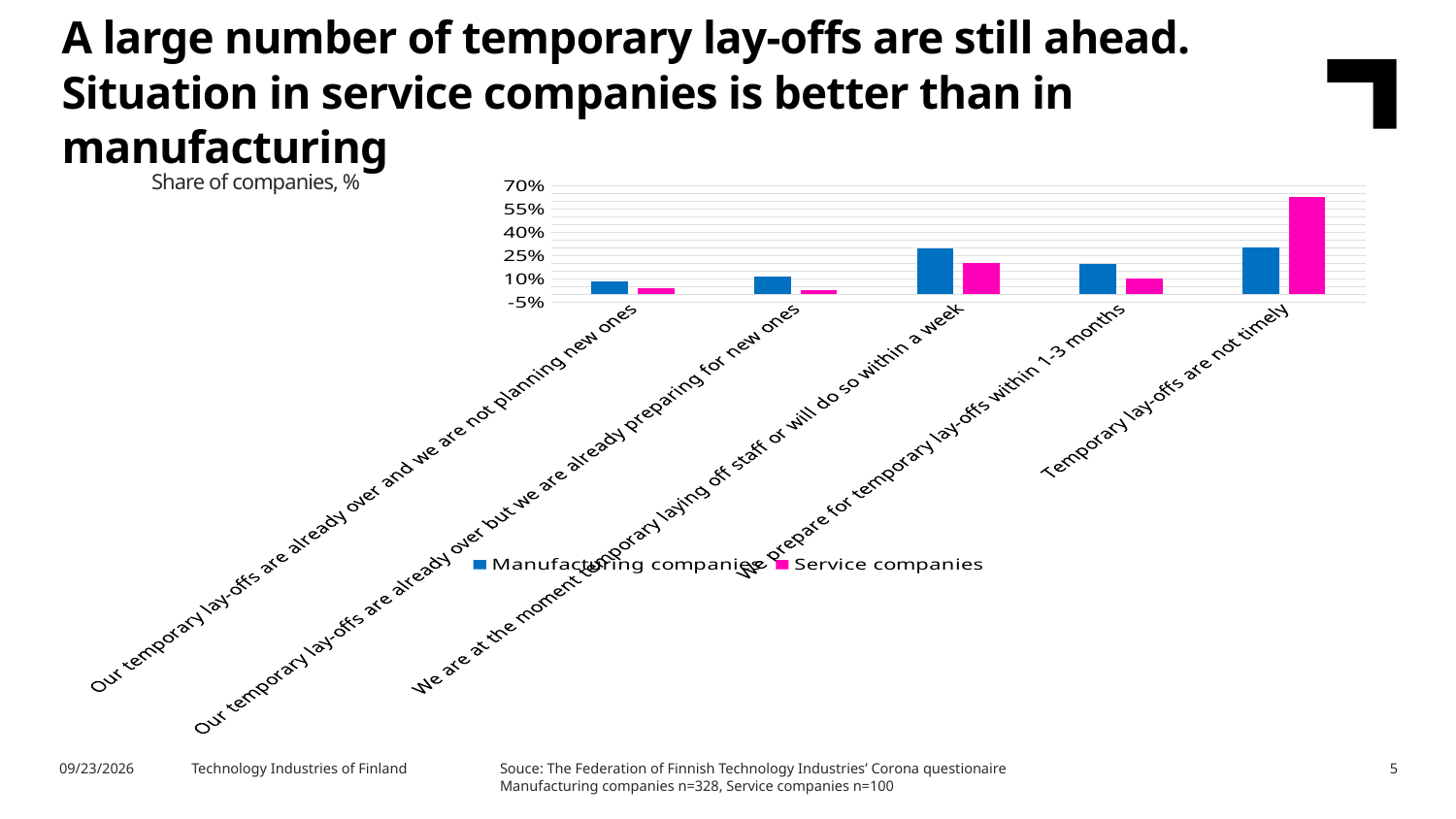
For the category 'We are at the moment temporary laying off staff or will do so within a week', which series has the larger value, Manufacturing companies or Service companies? Manufacturing companies How many series does the legend list? 2 What kind of chart is shown on the slide? Bar chart How many categories are shown on the x axis? 5 Which colour represents Service companies in the chart? Pink Is the value for Service companies in 'Temporary lay-offs are not timely' greater or less than 55%? greater For the category 'Temporary lay-offs are not timely', which series has the larger value, Manufacturing companies or Service companies? Service companies Is the value for Manufacturing companies in 'We prepare for temporary lay-offs within 1-3 months' greater or less than 10%? greater For which category is the value for Service companies highest? Temporary lay-offs are not timely Is the value for Manufacturing companies in 'We are at the moment temporary laying off staff or will do so within a week' greater or less than 25%? greater What does the label above the chart say the values represent? Share of companies, %